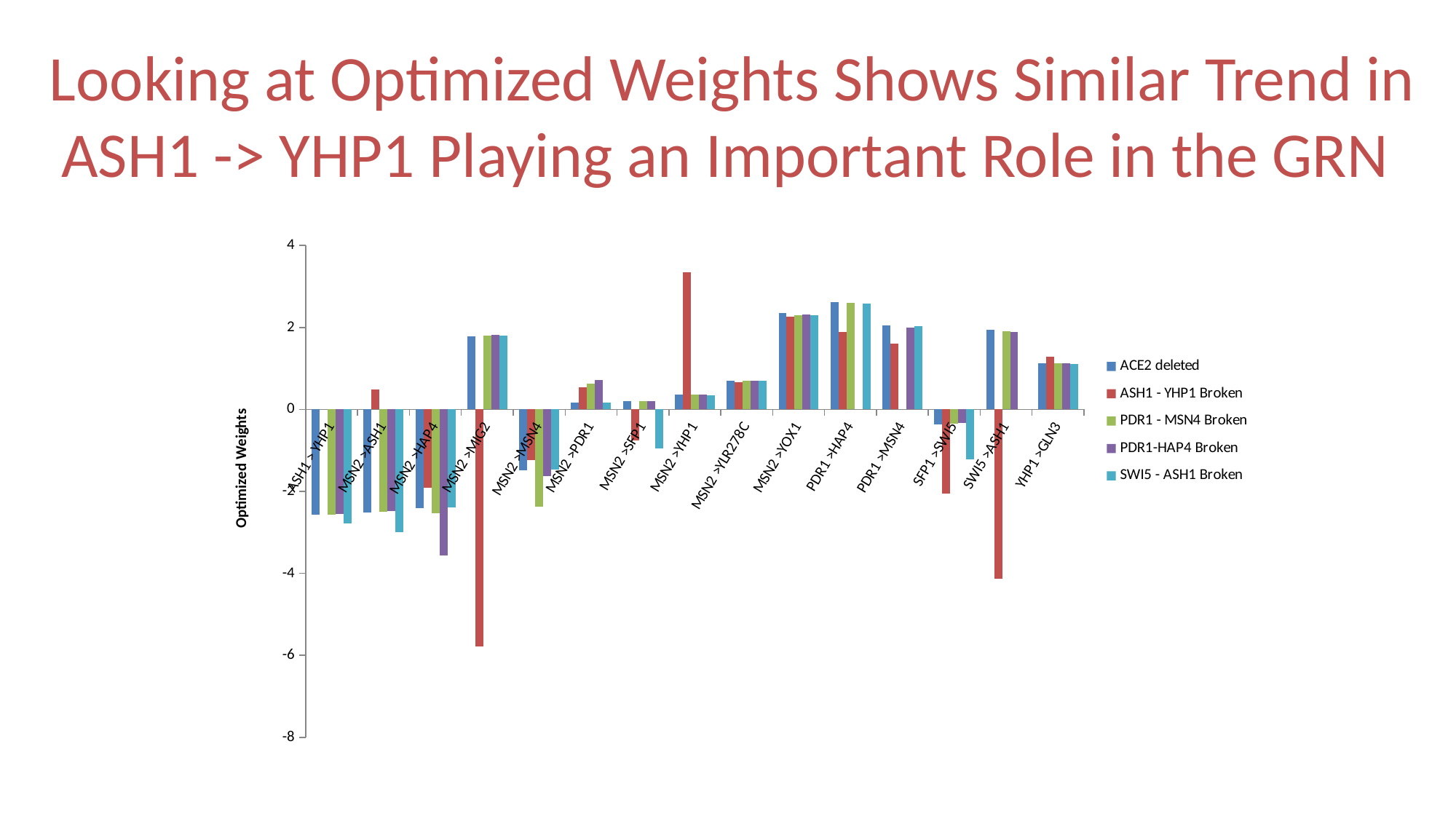
Is the value for ASH1 - YHP1 Broken at MSN2 ->MIG2 greater or less than -4? less Is the value for ASH1 - YHP1 Broken at MSN2 ->YHP1 greater or less than 2? greater How many categories are shown along the x axis? 15 What kind of chart is shown on the slide? bar chart Is the value for PDR1-HAP4 Broken at MSN2 ->HAP4 greater or less than -2? less How many series does the legend list? 5 What is the label of the vertical axis? Optimized Weights Which category has the highest value for the ASH1 - YHP1 Broken series? MSN2 ->YHP1 Which category has the lowest value for the ASH1 - YHP1 Broken series? MSN2 ->MIG2 For the ASH1 - YHP1 Broken series, which is lower: the value at MSN2 ->MIG2 or at SWI5 ->ASH1? MSN2 ->MIG2 Which series is shown in red in the legend? ASH1 - YHP1 Broken